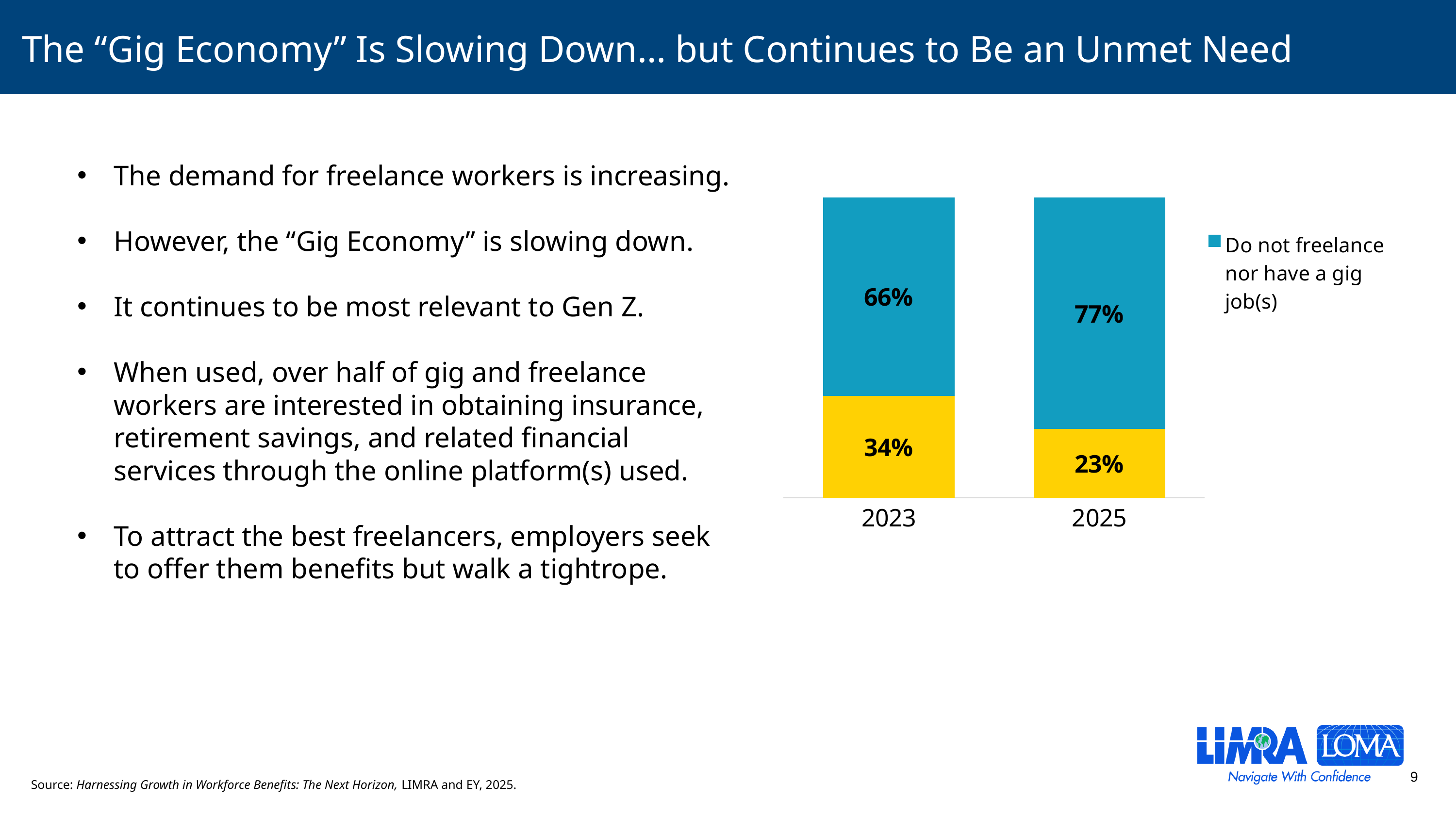
What kind of chart is shown on the slide? stacked bar chart What is the total of the stacked bar for 2023? 100% What is the value for "Do not freelance nor have a gig job(s)" in 2025? 77% What is the value of the yellow segment for 2025? 23% What is the value of the yellow segment for 2023? 34% How many categories are shown on the x axis of the chart? 2 What is the difference between the "Do not freelance nor have a gig job(s)" values for 2025 and 2023? 11% Does the value for "Do not freelance nor have a gig job(s)" rise or fall from 2023 to 2025? rise Which year has the higher value for "Do not freelance nor have a gig job(s)", 2023 or 2025? 2025 How many series does the chart's legend list? 1 What is the value for "Do not freelance nor have a gig job(s)" in 2023? 66% Which year has the lower value for the yellow segment? 2025